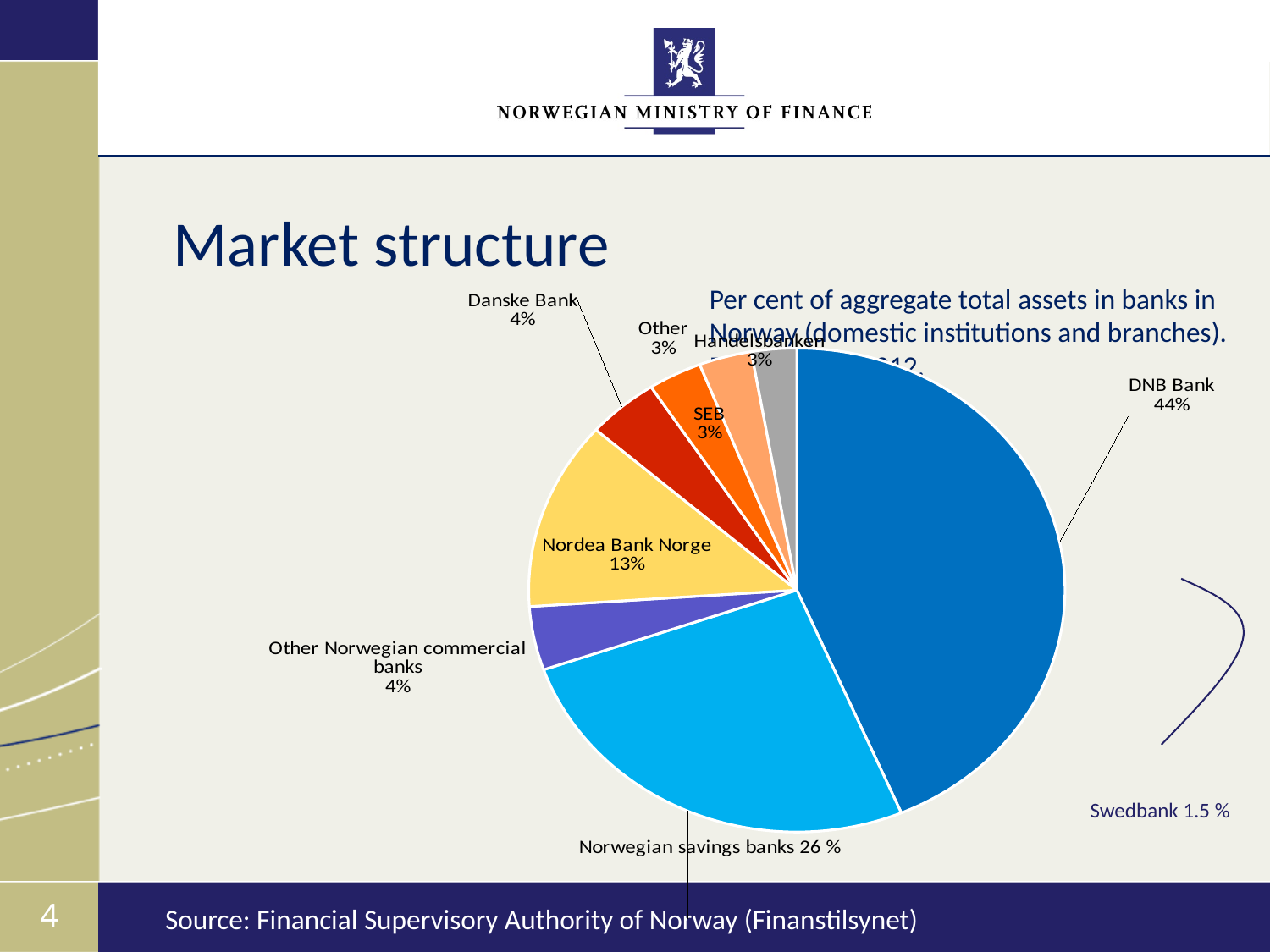
What share is shown for SEB? 3% Which bank has the smallest share in the pie chart? Swedbank Which has the larger share: Nordea Bank Norge or Norwegian savings banks? Norwegian savings banks Which bank or group has the largest slice of the pie chart? DNB Bank How many percentage points larger is DNB Bank's share than Nordea Bank Norge's share? 31 What share of aggregate total assets do Norwegian savings banks hold? 26 % What share is shown for Danske Bank? 4% What type of chart is shown on the slide? Pie chart What is the share shown for Nordea Bank Norge? 13% What share is shown for Swedbank? 1.5 % What is the source cited for the chart at the bottom of the slide? Financial Supervisory Authority of Norway (Finanstilsynet) What share of aggregate total assets does DNB Bank hold in the pie chart? 44%